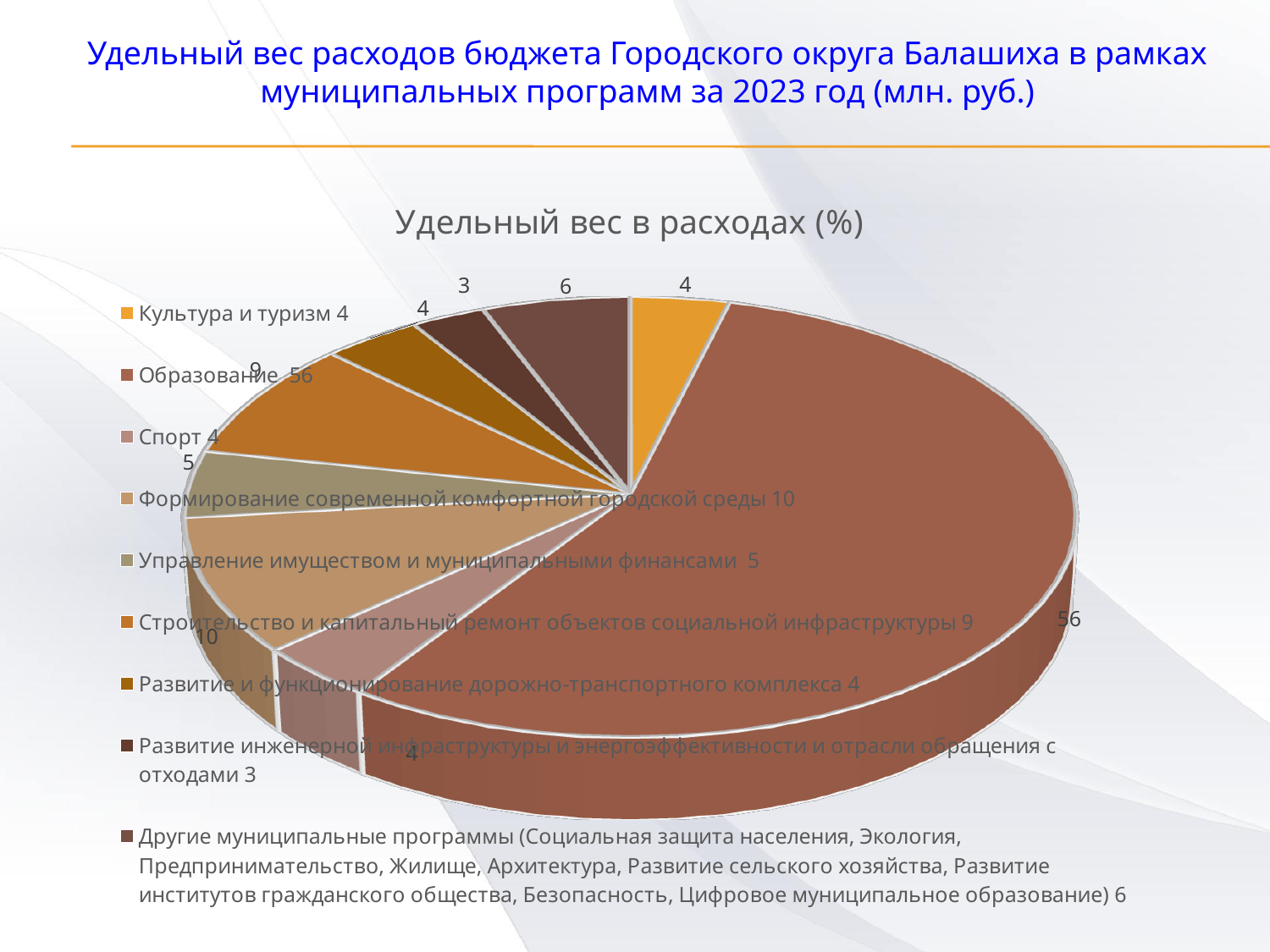
What kind of chart is shown on the slide? pie chart What is the difference between the values for Образование and Формирование современной комфортной городской среды? 46 Which is larger: the value for Строительство и капитальный ремонт объектов социальной инфраструктуры or the value for Другие муниципальные программы? Строительство и капитальный ремонт объектов социальной инфраструктуры What is the value for Строительство и капитальный ремонт объектов социальной инфраструктуры? 9 What is the title of the chart? Удельный вес в расходах (%) Which category has the smallest slice of the pie? Развитие инженерной инфраструктуры и энергоэффективности и отрасли обращения с отходами What is the value for Управление имуществом и муниципальными финансами? 5 What is the value for Формирование современной комфортной городской среды? 10 How many categories does the pie chart have? 9 What is the value for Культура и туризм? 4 What is the value for Образование? 56 Which category has the largest slice of the pie? Образование